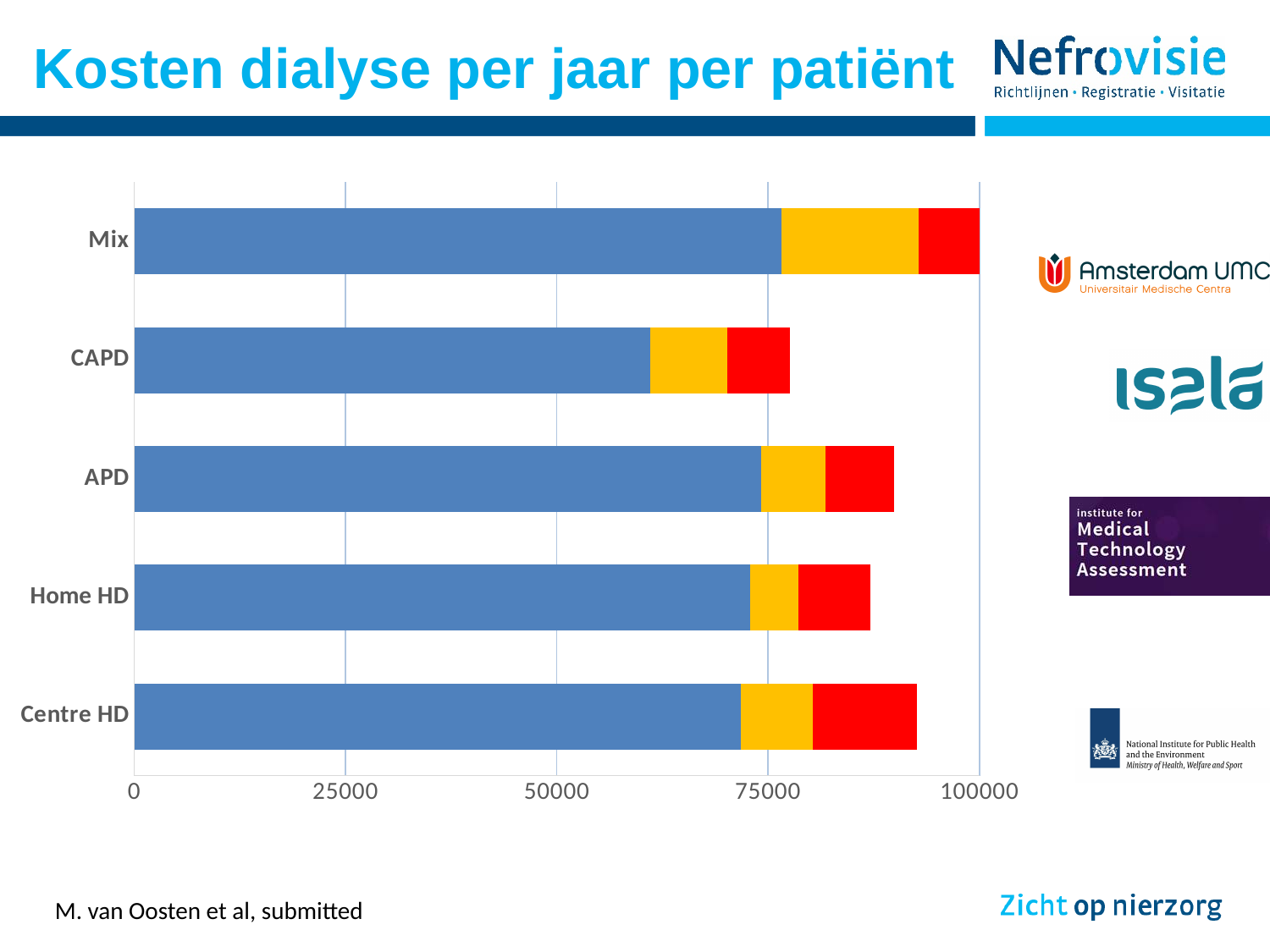
Is the total value for APD greater or less than 75000? greater Which category has the lowest total cost in the chart? CAPD Which has the larger total value, CAPD or Home HD? Home HD Is the total value for CAPD greater or less than 75000? greater Is the blue segment for Centre HD greater or less than 75000? less How many dialysis categories are shown on the y axis of the chart? 5 Which category has the highest total cost in the chart? Mix What kind of chart is shown on the slide? Stacked bar chart How many coloured segments make up each bar in the chart? 3 What is the title of the slide containing the chart? Kosten dialyse per jaar per patiënt Which has the larger total value, Mix or Centre HD? Mix